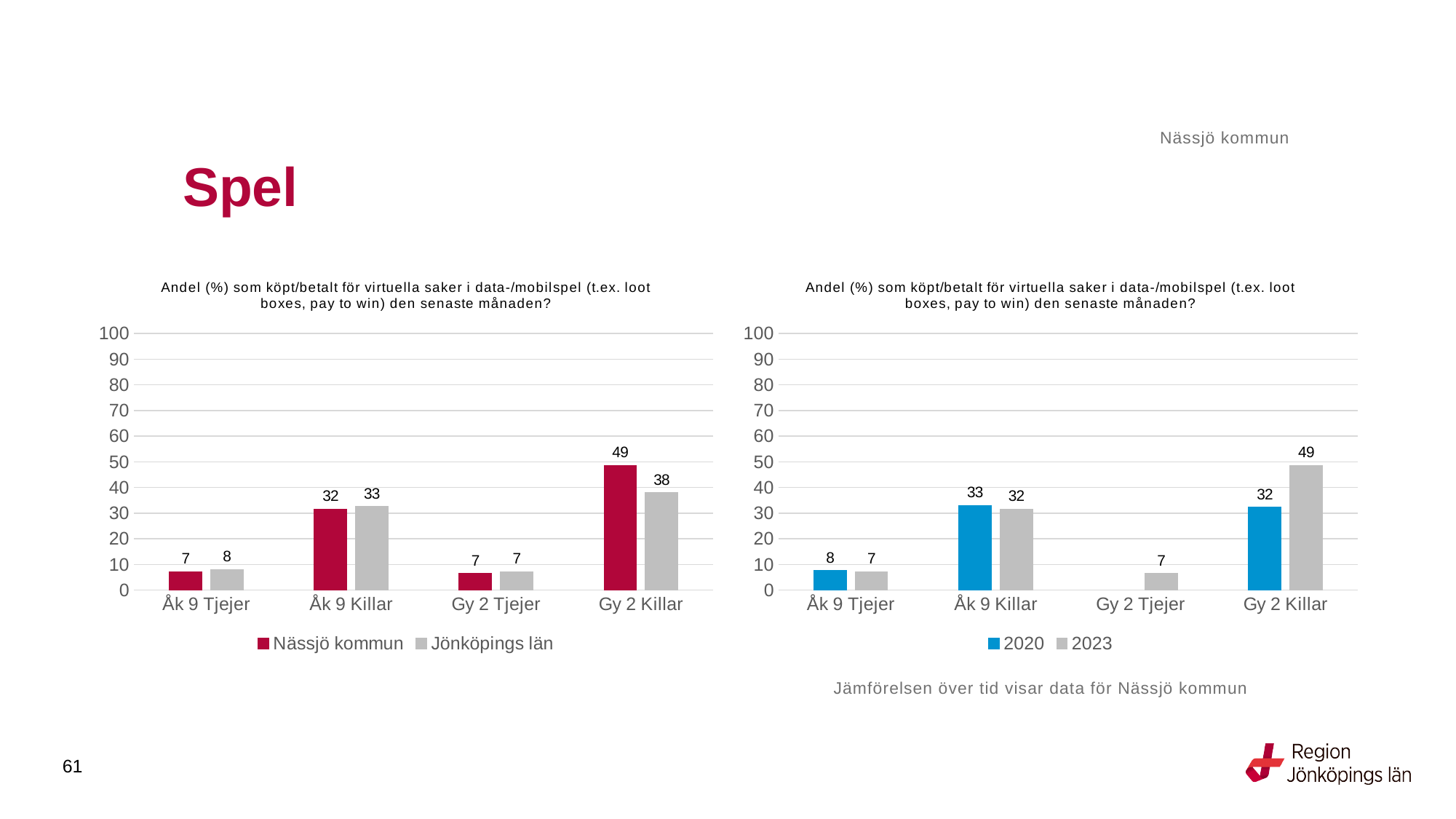
In the left chart, how many series does the legend list? 2 In the left chart, which category has the highest value for Nässjö kommun? Gy 2 Killar In the right chart, how many categories are shown on the x axis? 4 In the right chart, which series does the blue colour represent? 2020 In the left chart, what kind of chart is shown? Bar chart In the right chart, what is the value for 2023 for Gy 2 Killar? 49 In the left chart, what is the difference between Nässjö kommun and Jönköpings län for Gy 2 Killar? 11 In the left chart, what is the value for Jönköpings län for Åk 9 Killar? 33 In the right chart, what is the difference between 2023 and 2020 for Gy 2 Killar? 17 In the right chart, what is the value for 2020 for Åk 9 Killar? 33 In the right chart, which is larger for Gy 2 Killar, 2020 or 2023? 2023 In the left chart, what is the value for Nässjö kommun for Gy 2 Killar? 49